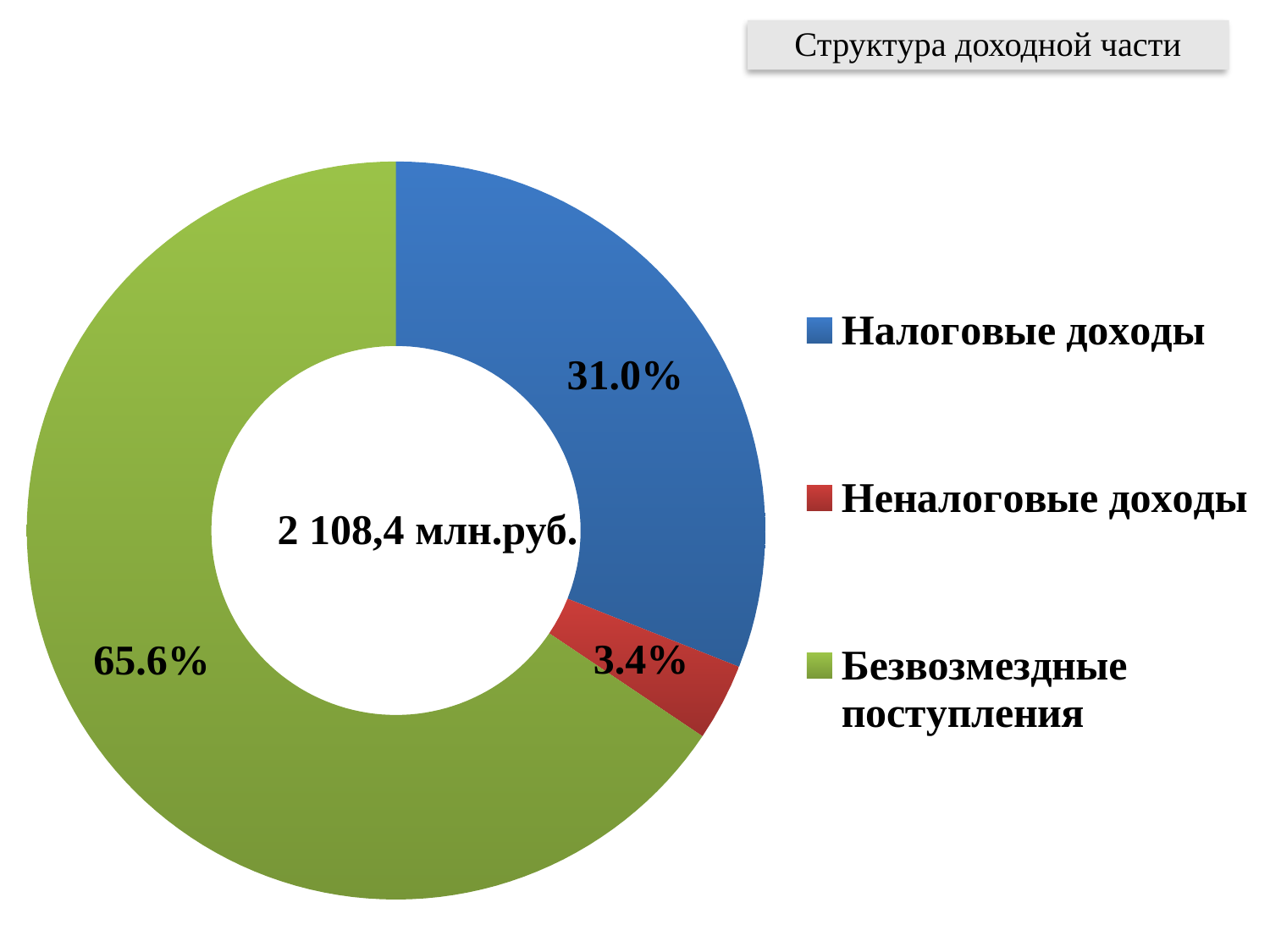
What is the difference in percentage points between Безвозмездные поступления and Налоговые доходы? 34.6 What share of the chart does Безвозмездные поступления account for? 65.6% Which category has the largest share of the chart? Безвозмездные поступления Which category has the smallest share of the chart? Неналоговые доходы How many categories are shown in the chart? 3 What share of the chart does Неналоговые доходы account for? 3.4% Is the share for Налоговые доходы greater or less than 50%? less Which is larger, the share for Налоговые доходы or the share for Неналоговые доходы? Налоговые доходы What is the title shown on the slide? Структура доходной части What kind of chart is shown on the slide? Pie chart (doughnut) What total value is printed in the centre of the chart? 2 108,4 млн.руб. What share of the chart does Налоговые доходы account for? 31.0%